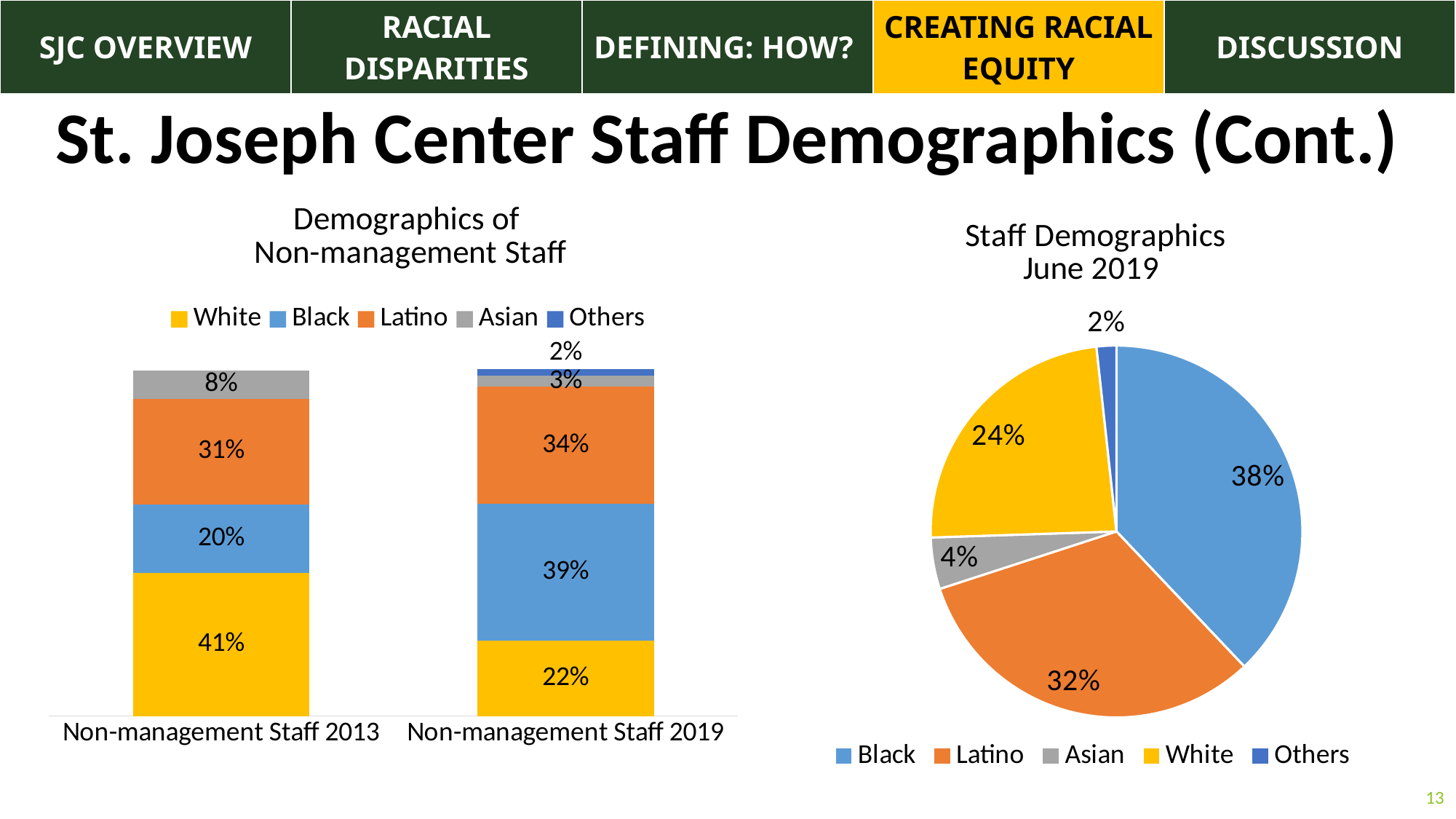
In the 'Demographics of Non-management Staff' chart, which is larger: White in 2013 or White in 2019? White in 2013 In the 'Demographics of Non-management Staff' chart, what is the difference between the Latino values for 2019 and 2013? 3% In the 'Staff Demographics June 2019' pie chart, what is the share for Latino? 32% In the 'Staff Demographics June 2019' pie chart, which category has the largest slice? Black In the 'Staff Demographics June 2019' pie chart, which category has the smallest slice? Others In the 'Demographics of Non-management Staff' chart, what is the total of the Non-management Staff 2019 stacked bar? 100% In the 'Demographics of Non-management Staff' chart, how many series does the legend list? 5 In the 'Demographics of Non-management Staff' chart, what is the value for Black in Non-management Staff 2019? 39% In the 'Demographics of Non-management Staff' chart, what is the value for White in Non-management Staff 2013? 41% In the 'Demographics of Non-management Staff' chart, what is the value for Asian in Non-management Staff 2013? 8% What kind of chart is 'Demographics of Non-management Staff'? Stacked bar chart In the 'Staff Demographics June 2019' pie chart, what is the difference between the Black and White shares? 14%